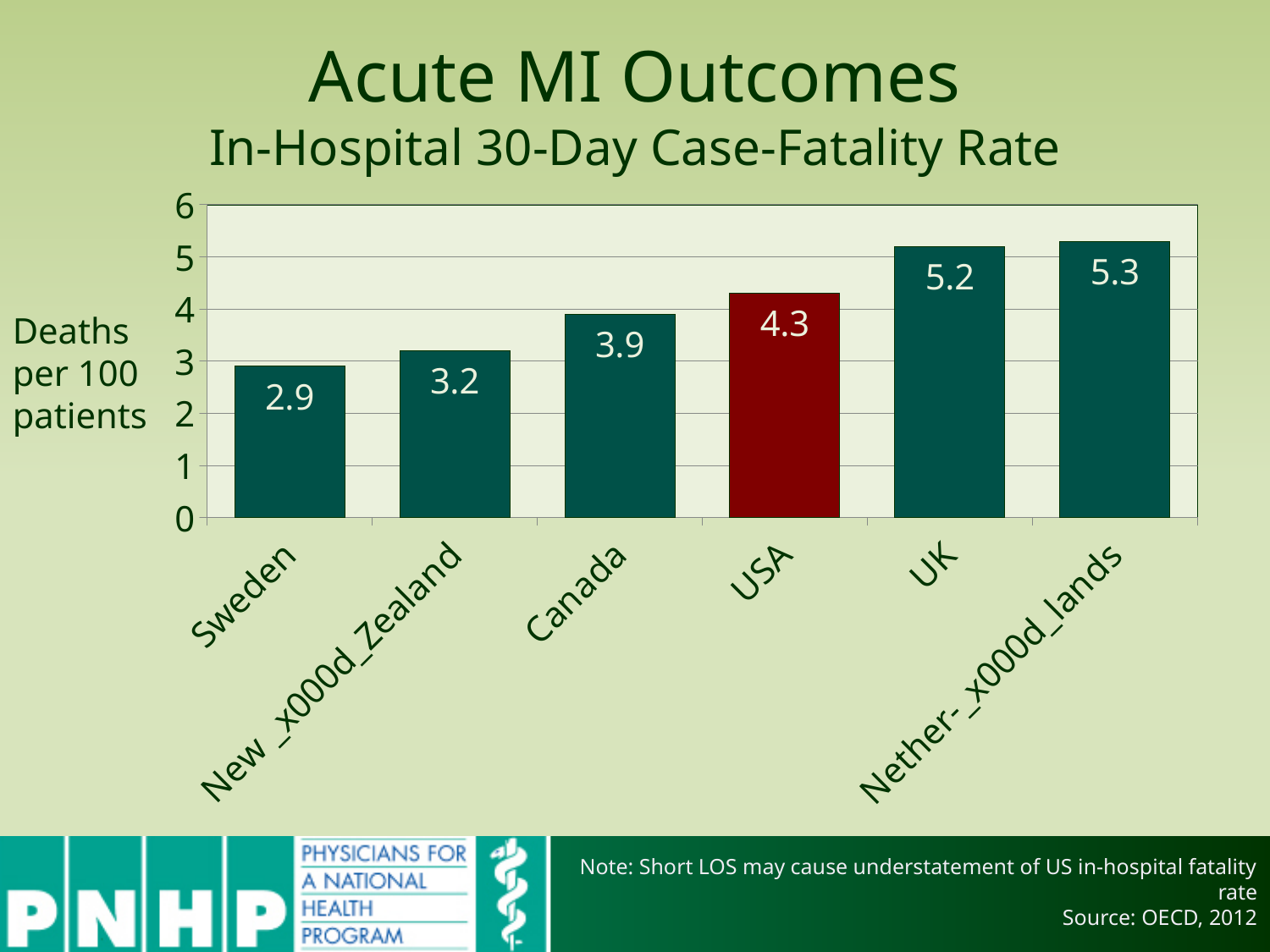
Which country's bar is coloured red rather than dark green? USA Which has a higher case-fatality rate, Canada or the USA? USA What is the value shown for the UK? 5.2 What is the value shown for Canada? 3.9 What type of chart is shown on the slide? Bar chart Which country has the lowest case-fatality rate? Sweden Which country has the highest case-fatality rate? Netherlands What is the difference between the USA's value and Sweden's value? 1.4 How many countries are shown in the chart? 6 What is the in-hospital 30-day case-fatality rate for the USA? 4.3 What is the value shown for Sweden? 2.9 What is the difference between the Netherlands' value and the UK's value? 0.1